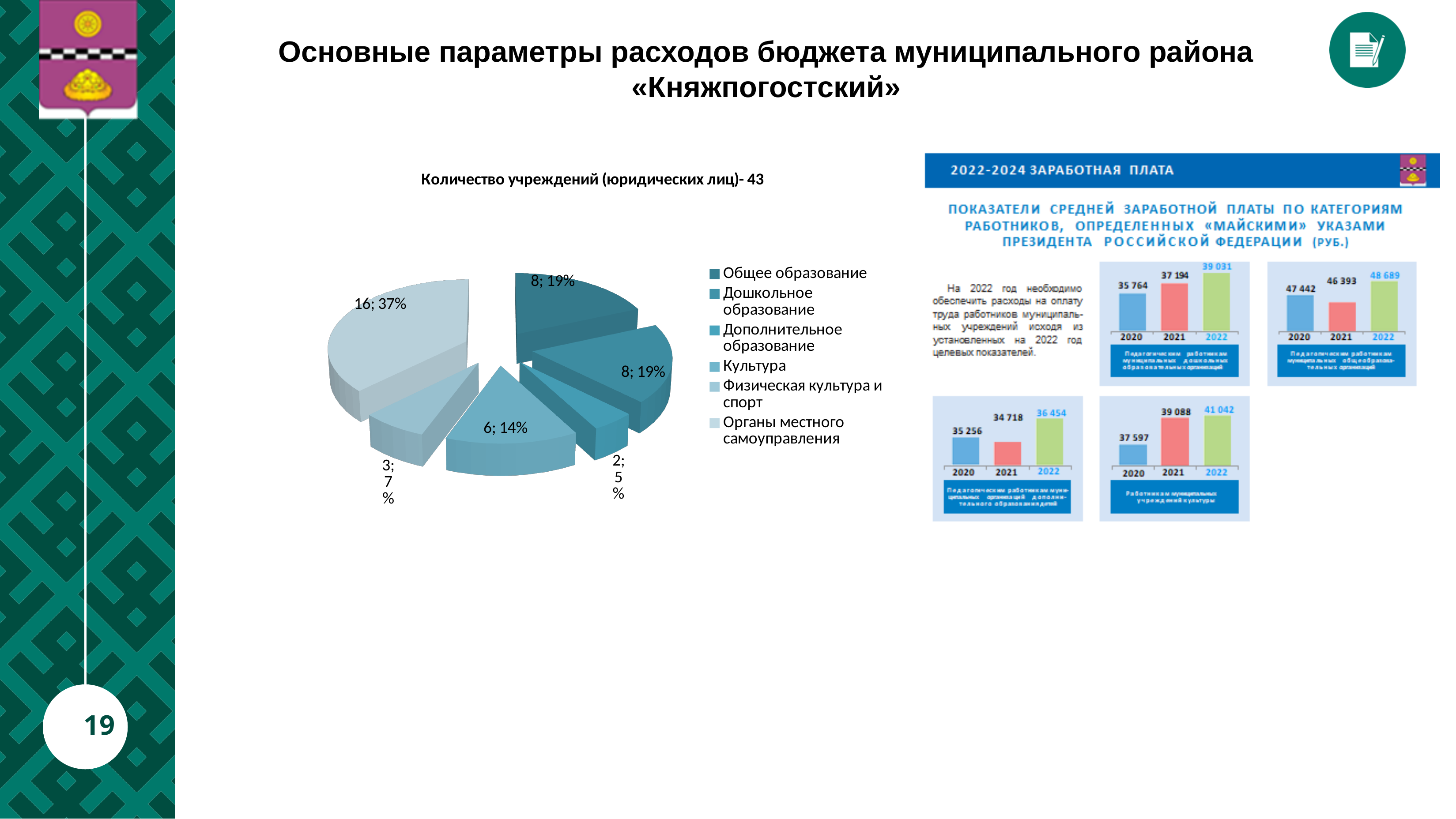
In the pie chart 'Количество учреждений (юридических лиц)- 43', what share does 'Физическая культура и спорт' have? 7% In the salary panel on the right of the slide, what is the 2022 value in the top-right bar chart? 48 689 How many categories does the pie chart 'Количество учреждений (юридических лиц)- 43' show? 6 In the pie chart 'Количество учреждений (юридических лиц)- 43', how many institutions are shown for 'Органы местного самоуправления'? 16 What kind of chart is 'Количество учреждений (юридических лиц)- 43'? pie chart In the pie chart 'Количество учреждений (юридических лиц)- 43', how many more institutions does 'Органы местного самоуправления' have than 'Общее образование'? 8 In the pie chart 'Количество учреждений (юридических лиц)- 43', what is the value for 'Культура'? 6 In the pie chart 'Количество учреждений (юридических лиц)- 43', which category has the largest slice? Органы местного самоуправления In the pie chart 'Количество учреждений (юридических лиц)- 43', what share does 'Органы местного самоуправления' have? 37% In the pie chart 'Количество учреждений (юридических лиц)- 43', which category has the smallest slice? Дополнительное образование According to the title of the pie chart, what is the total number of institutions (legal entities)? 43 In the pie chart 'Количество учреждений (юридических лиц)- 43', which has more institutions: 'Культура' or 'Физическая культура и спорт'? Культура